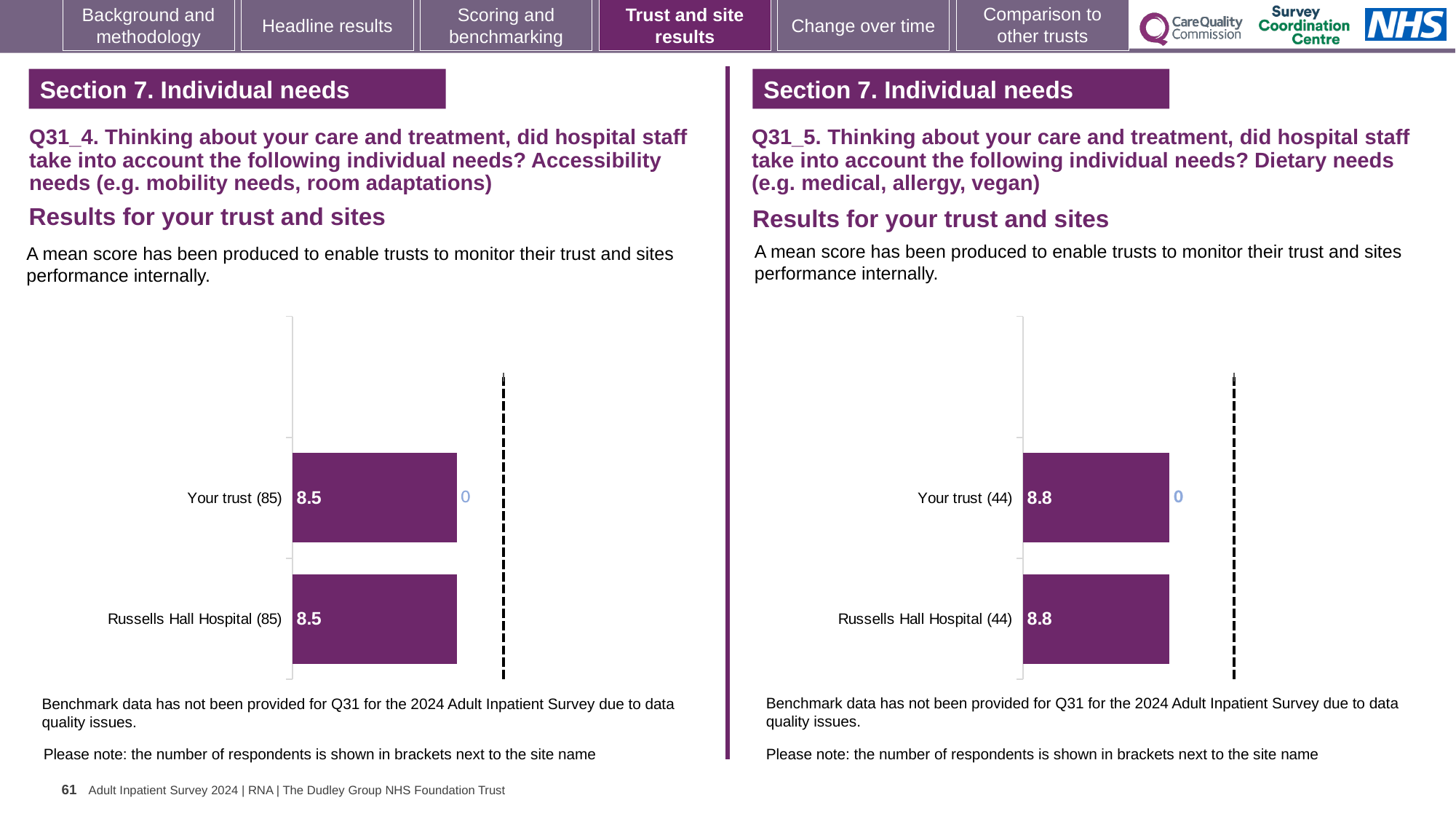
What type of chart is used in the right chart (Q31_5, Dietary needs)? Bar chart In the left chart (Q31_4, Accessibility needs), what is the difference between the scores for Your trust and Russells Hall Hospital? 0 In the left chart (Q31_4, Accessibility needs), what is the mean score for Your trust? 8.5 How many bars are plotted in the right chart (Q31_5, Dietary needs)? 2 How many bars are plotted in the left chart (Q31_4, Accessibility needs)? 2 In the right chart (Q31_5, Dietary needs), what is the difference between the scores for Your trust and Russells Hall Hospital? 0 In the left chart (Q31_4, Accessibility needs), how many respondents are shown in brackets next to Your trust? 85 Is the Your trust score in the right chart (Q31_5, Dietary needs) higher or lower than the Your trust score in the left chart (Q31_4, Accessibility needs)? Higher In the right chart (Q31_5, Dietary needs), what is the mean score for Your trust? 8.8 In the right chart (Q31_5, Dietary needs), how many respondents are shown in brackets next to Russells Hall Hospital? 44 In the right chart (Q31_5, Dietary needs), what is the mean score for Russells Hall Hospital? 8.8 In the left chart (Q31_4, Accessibility needs), what is the mean score for Russells Hall Hospital? 8.5